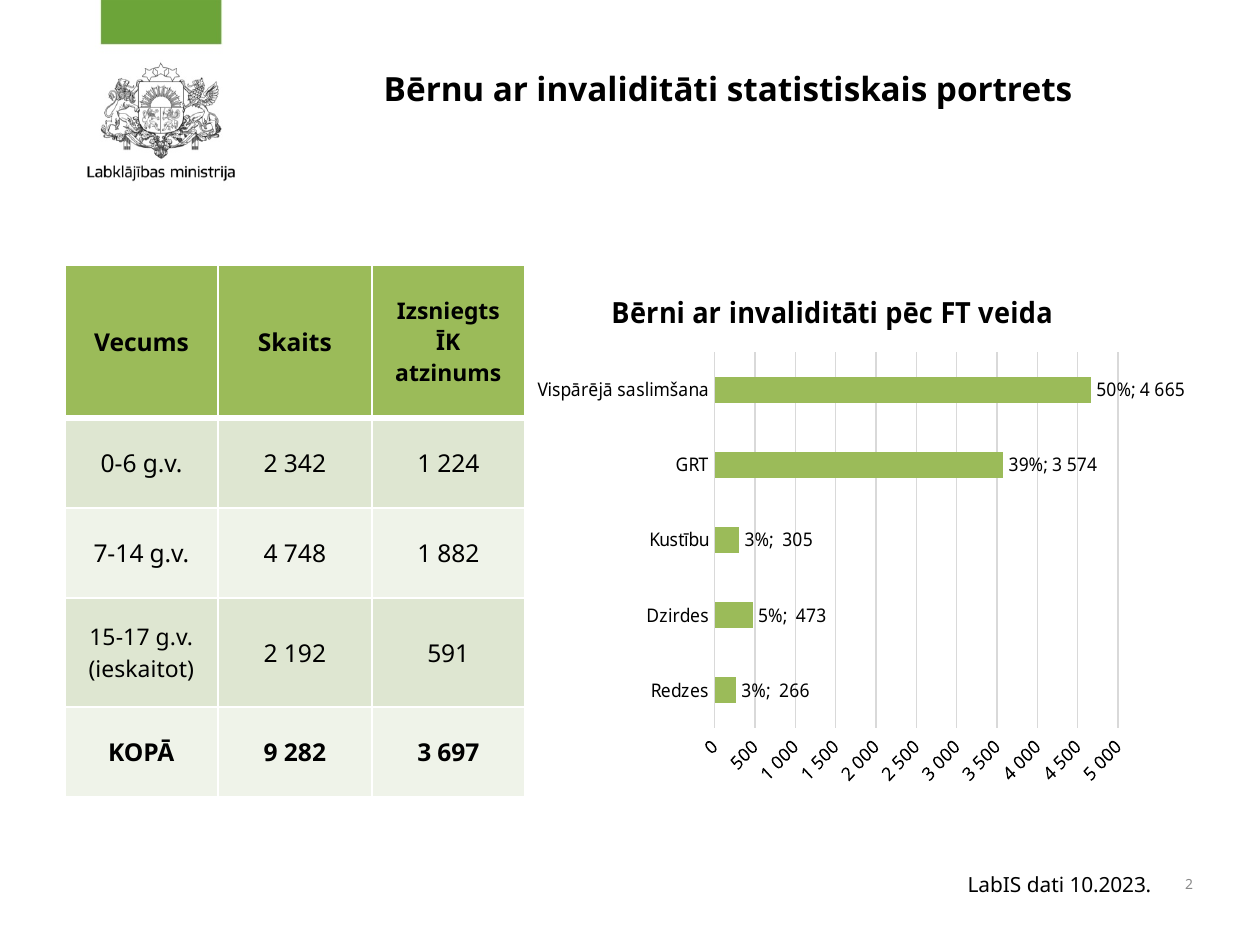
What kind of chart is shown on the slide? bar chart What is the difference between the values for Vispārējā saslimšana and GRT? 1 091 What is the value shown for Redzes? 266 Which category has the lowest value? Redzes Which category has the highest value? Vispārējā saslimšana How many categories does the chart show? 5 Which is larger, the value for Kustību or the value for Dzirdes? Dzirdes Is the value for GRT greater or less than 3 000? greater What is the title of the chart on the slide? Bērni ar invaliditāti pēc FT veida What is the value shown for Dzirdes? 473 What percentage is shown for GRT? 39% What is the value shown for Vispārējā saslimšana? 4 665